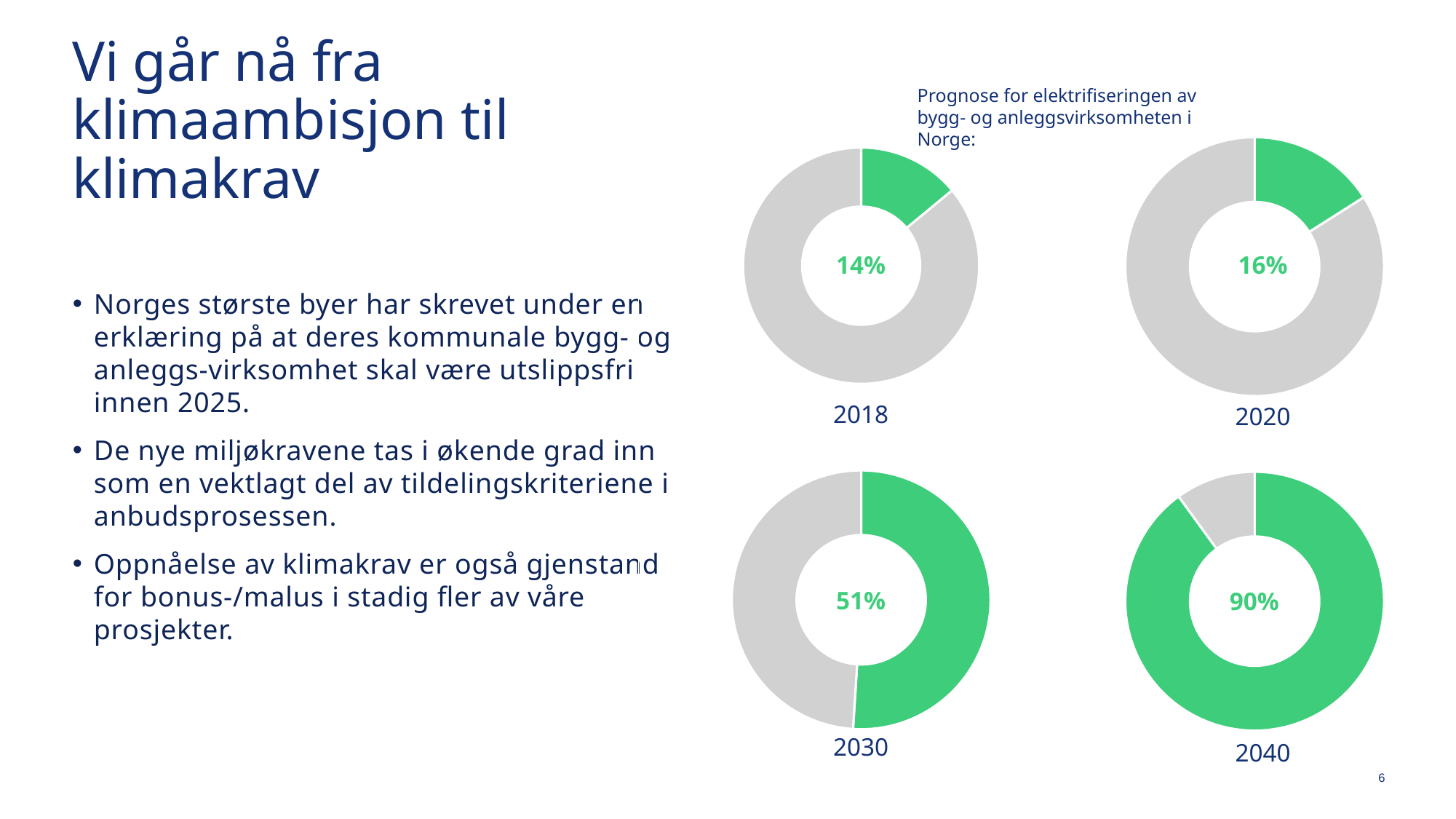
How many donut charts are shown on the slide? 4 What kind of chart is used to show the electrification forecast for each year? Donut chart Do the values in the donut charts rise or fall from 2018 to 2040? Rise What is the difference between the value in the 2040 donut chart and the value in the 2030 donut chart? 39% What value is shown in the centre of the 2018 donut chart? 14% What value is shown in the centre of the 2040 donut chart? 90% Across the four donut charts, which year shows the lowest electrification share? 2018 What is the difference between the value in the 2020 donut chart and the value in the 2018 donut chart? 2% Which is larger: the value in the 2030 donut chart or the value in the 2020 donut chart? 2030 What value is shown in the centre of the 2030 donut chart? 51% What value is shown in the centre of the 2020 donut chart? 16% Across the four donut charts, which year shows the highest electrification share? 2040